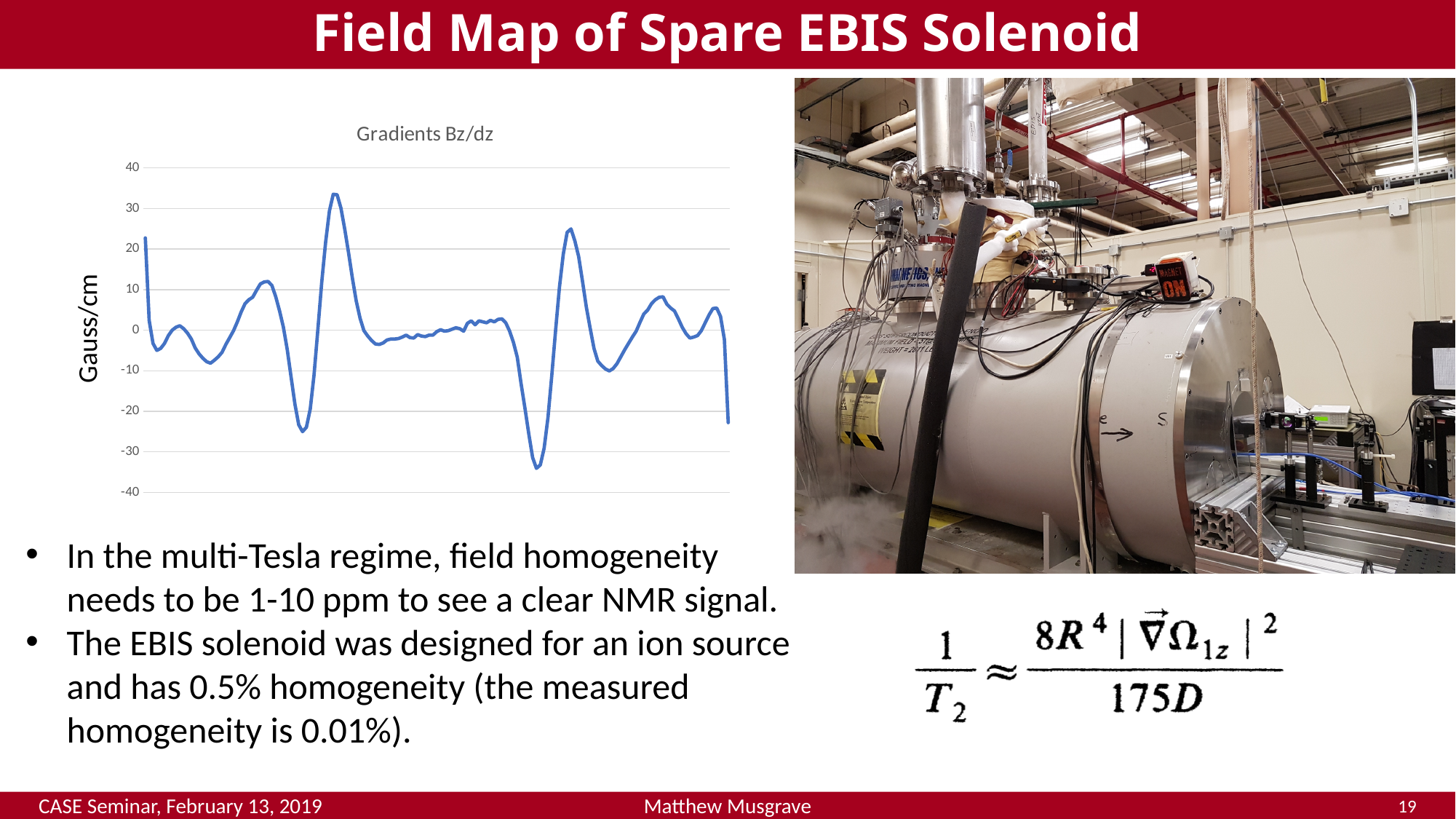
Is the highest peak of the plotted line greater or less than 30 Gauss/cm? greater What kind of chart is shown on the slide? line chart What is the title of the chart? Gradients Bz/dz Is the value at the very start of the plotted line greater or less than 20 Gauss/cm? greater Which is larger: the first large positive peak (left of centre) or the second large positive peak (right of centre)? the first large positive peak What is the maximum value shown on the vertical axis of the chart? 40 What is the label on the vertical axis of the chart? Gauss/cm How many data series are plotted on the chart? 1